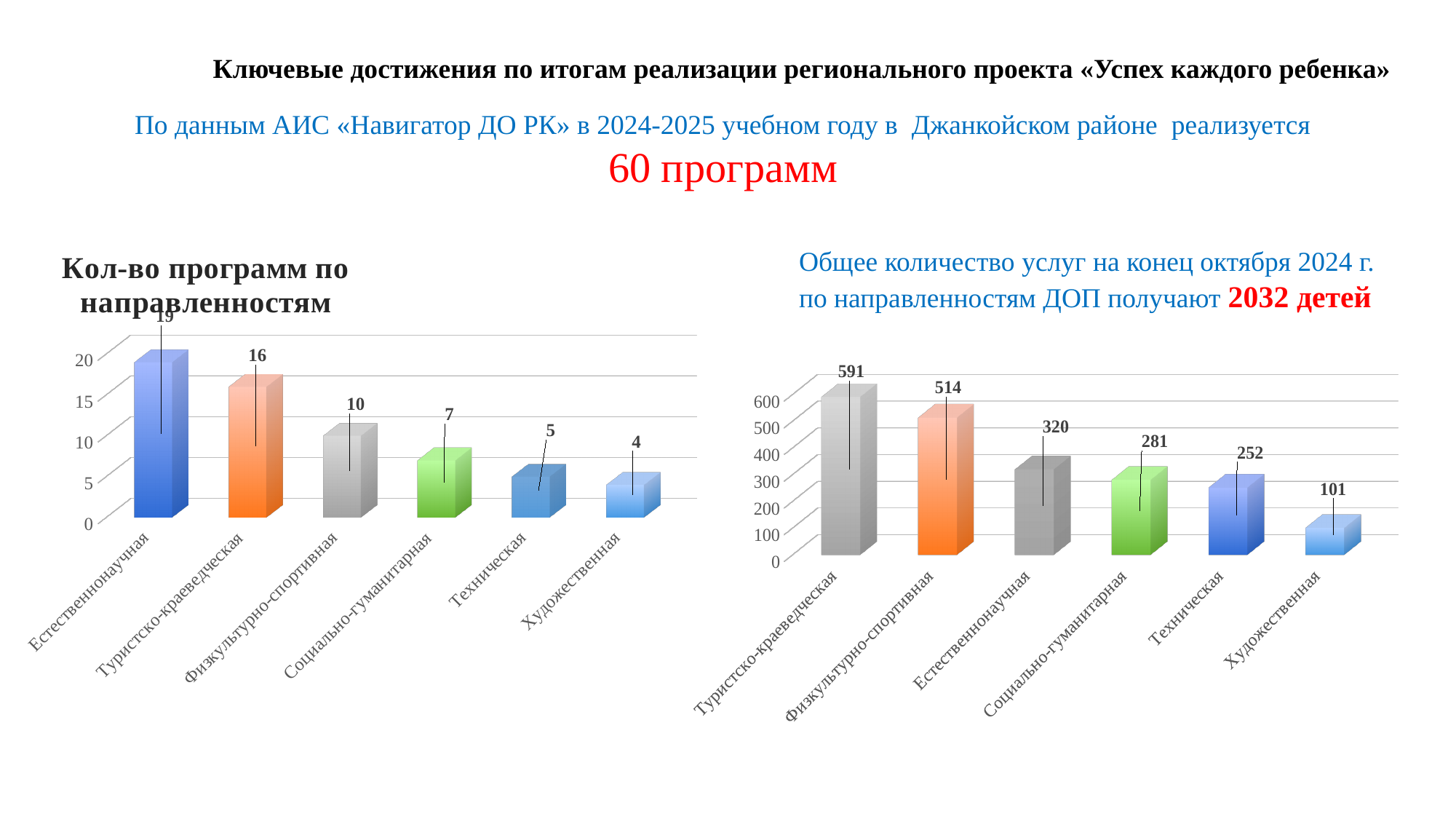
In the left chart 'Кол-во программ по направленностям', which category has the lowest value? Художественная In the right chart (number of services by направленность), what is the value for Туристско-краеведческая? 591 In the right chart (number of services by направленность), what is the difference between Физкультурно-спортивная and Естественнонаучная? 194 In the left chart 'Кол-во программ по направленностям', what is the value for Социально-гуманитарная? 7 In the left chart 'Кол-во программ по направленностям', what is the value for Туристско-краеведческая? 16 What type of chart is the right chart on the slide? Bar chart In the left chart 'Кол-во программ по направленностям', how many categories are shown? 6 In the left chart 'Кол-во программ по направленностям', which category has the highest value? Естественнонаучная In the left chart 'Кол-во программ по направленностям', what is the difference between Физкультурно-спортивная and Техническая? 5 In the right chart (number of services by направленность), what is the value for Художественная? 101 In the right chart (number of services by направленность), which category has the highest value? Туристско-краеведческая In the right chart (number of services by направленность), which is larger: Социально-гуманитарная or Техническая? Социально-гуманитарная